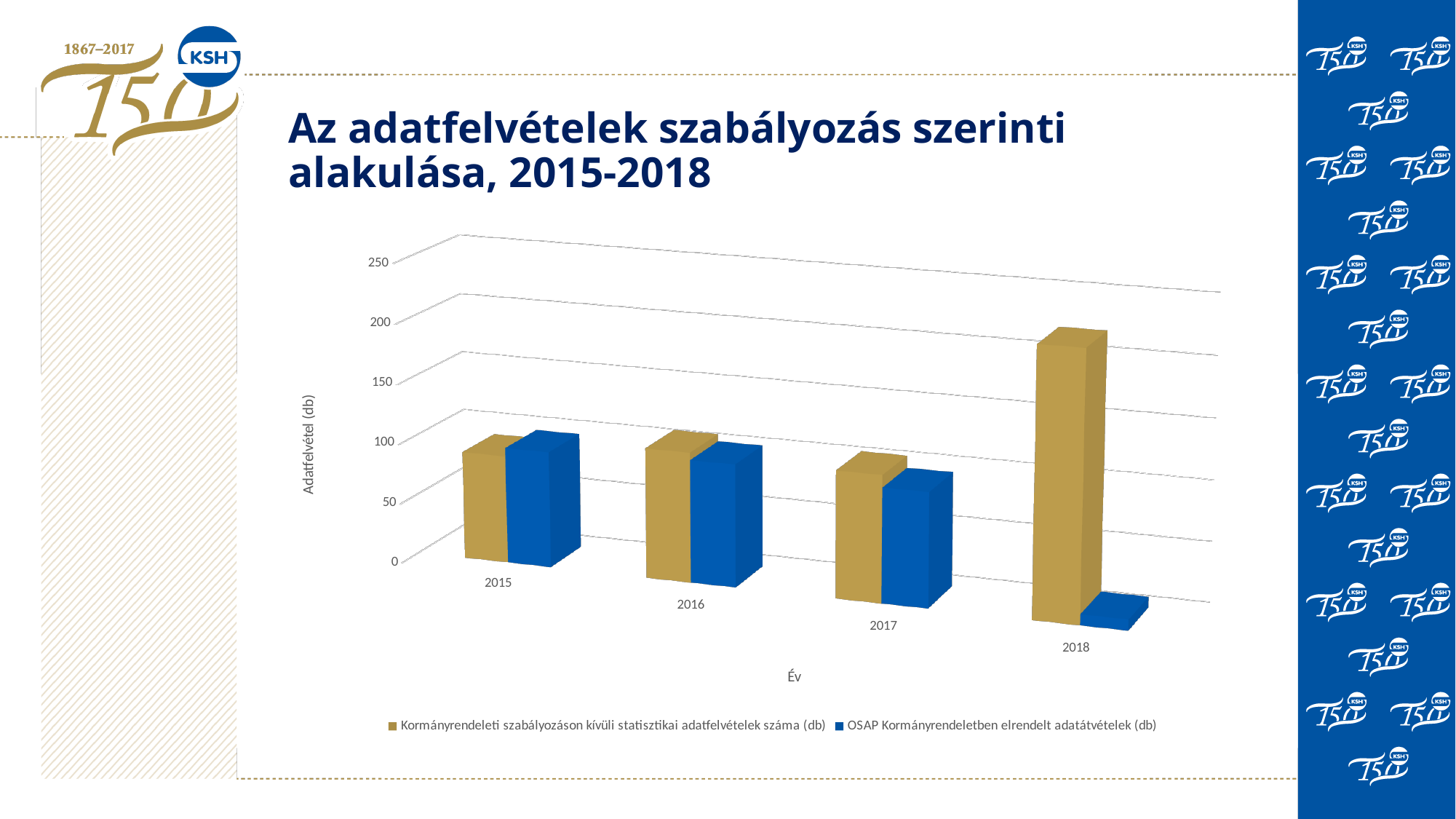
How many series does the legend list? 2 Is the 2018 value for 'Kormányrendeleti szabályozáson kívüli statisztikai adatfelvételek száma (db)' greater or less than 150? greater In 2018, which series has the larger value: 'Kormányrendeleti szabályozáson kívüli statisztikai adatfelvételek száma (db)' or 'OSAP Kormányrendeletben elrendelt adatátvételek (db)'? Kormányrendeleti szabályozáson kívüli statisztikai adatfelvételek száma (db) Does the value for 'OSAP Kormányrendeletben elrendelt adatátvételek (db)' rise or fall from 2015 to 2018? fall What is the title of the chart's horizontal axis? Év What kind of chart is shown on the slide? bar chart How many years are shown on the x axis? 4 In which year is the value for 'OSAP Kormányrendeletben elrendelt adatátvételek (db)' the lowest? 2018 Is the 2018 value for 'OSAP Kormányrendeletben elrendelt adatátvételek (db)' greater or less than 50? less What is the title of the chart's vertical axis? Adatfelvétel (db) In which year is the value for 'Kormányrendeleti szabályozáson kívüli statisztikai adatfelvételek száma (db)' the highest? 2018